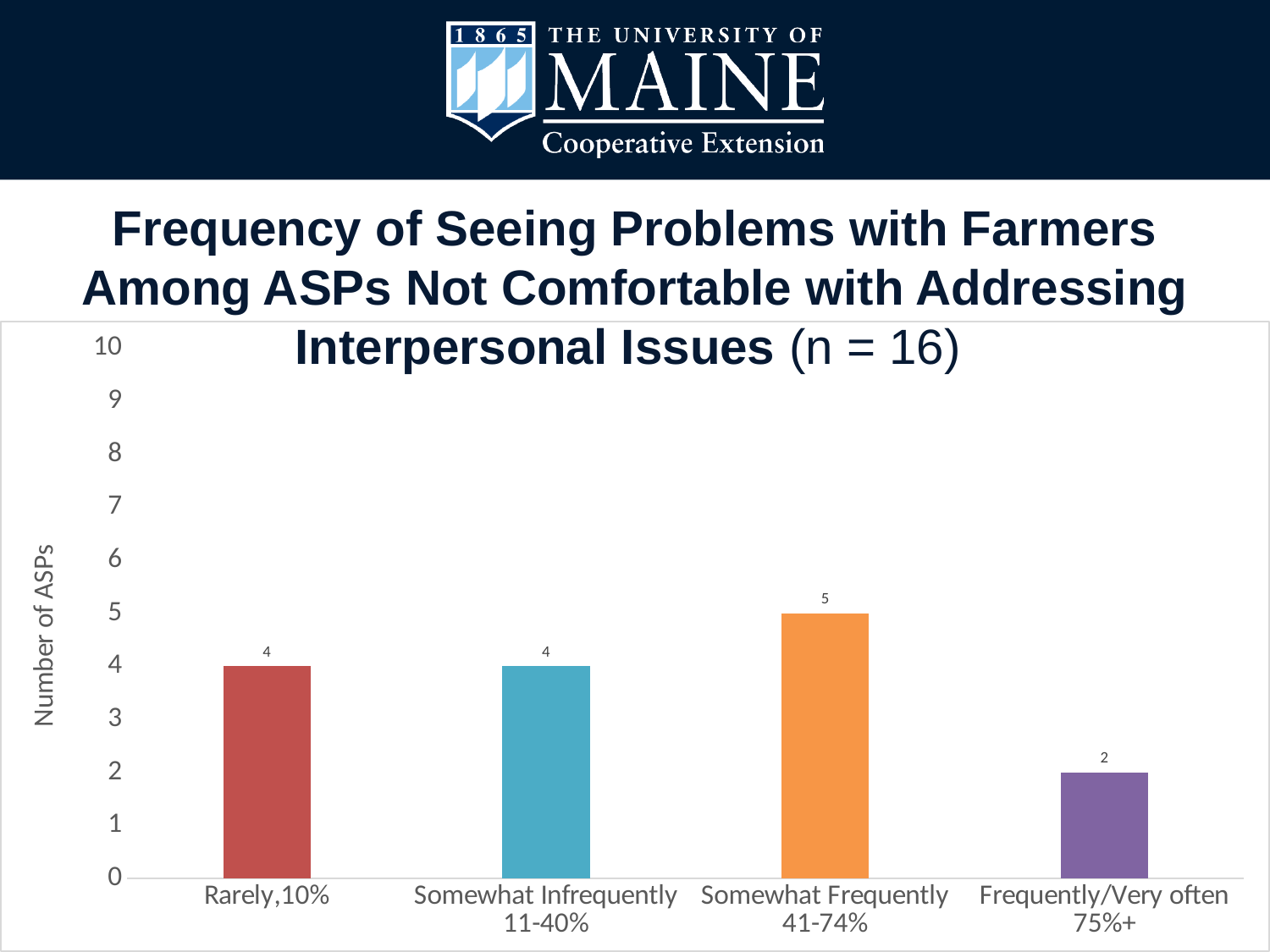
What is the total number of ASPs across all four categories? 15 What is the number of ASPs for the 'Frequently/Very often 75%+' category? 2 Which has more ASPs: 'Somewhat Infrequently 11-40%' or 'Frequently/Very often 75%+'? Somewhat Infrequently 11-40% Which category has the lowest number of ASPs? Frequently/Very often 75%+ Which category has the highest number of ASPs? Somewhat Frequently 41-74% What is the maximum value shown on the y axis? 10 What is the number of ASPs for the 'Rarely, 10%' category? 4 What is the label of the y axis? Number of ASPs What is the difference between the number of ASPs for 'Somewhat Frequently 41-74%' and 'Frequently/Very often 75%+'? 3 How many categories are shown on the x axis? 4 What is the number of ASPs for the 'Somewhat Frequently 41-74%' category? 5 What kind of chart is shown on the slide? Bar chart